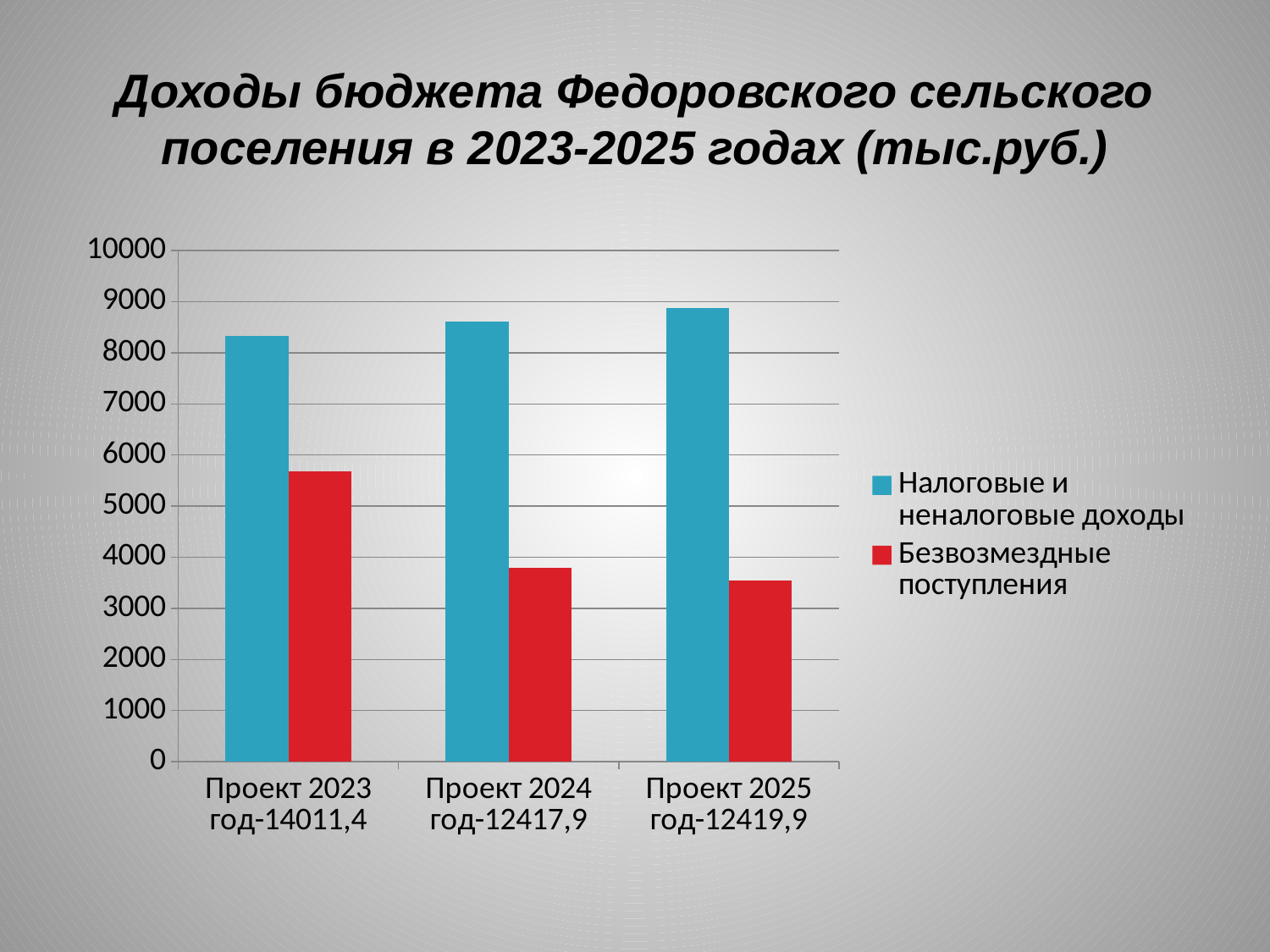
How many categories (years) are shown on the x axis? 3 How many series does the legend list? 2 Is the value for Налоговые и неналоговые доходы in Проект 2025 greater or less than 9000? less What kind of chart is shown on the slide? Bar chart Is the value for Безвозмездные поступления in Проект 2023 greater or less than 5000? greater Is the value for Безвозмездные поступления in Проект 2024 greater or less than 4000? less In Проект 2024, which series has the larger value: Налоговые и неналоговые доходы or Безвозмездные поступления? Налоговые и неналоговые доходы In which category is the value for Налоговые и неналоговые доходы the lowest? Проект 2023 год-14011,4 What total is printed in the x-axis label for Проект 2024? 12417,9 In which category is the value for Безвозмездные поступления the highest? Проект 2023 год-14011,4 In which category is the value for Налоговые и неналоговые доходы the highest? Проект 2025 год-12419,9 Do the values for Налоговые и неналоговые доходы rise or fall from Проект 2023 to Проект 2025? rise